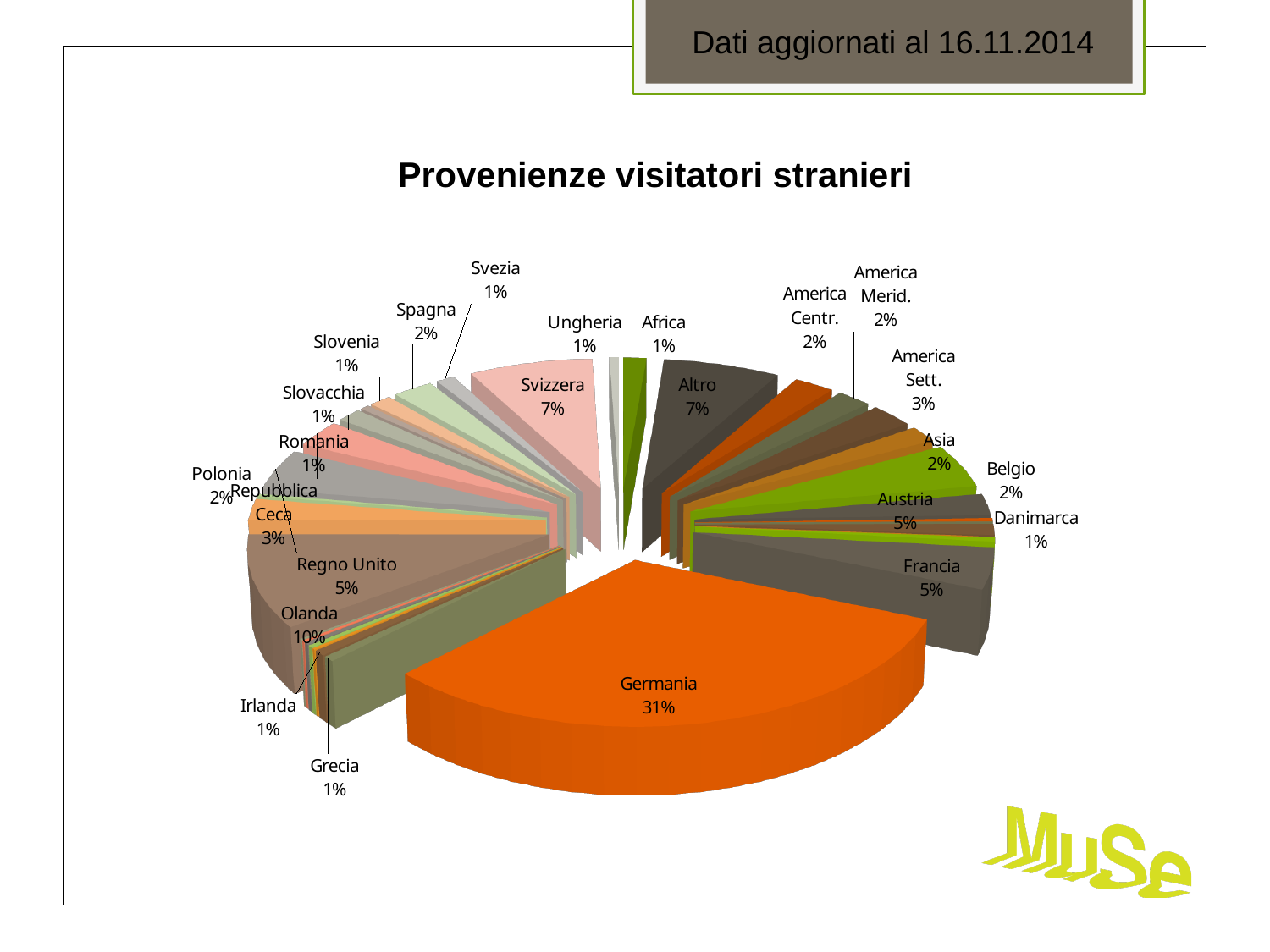
What is the difference in percentage points between Germania and Olanda? 21 What percentage is shown for Repubblica Ceca? 3% What share of foreign visitors comes from Germania? 31% What share of foreign visitors comes from Olanda? 10% Which is larger, the share for Altro or the share for Austria? Altro Which is larger, the share for Regno Unito or the share for Belgio? Regno Unito What percentage is shown for Svizzera? 7% What kind of chart is shown on the slide? pie chart Which country has the largest slice of the pie? Germania What percentage is shown for America Sett.? 3% What is the title of the chart? Provenienze visitatori stranieri